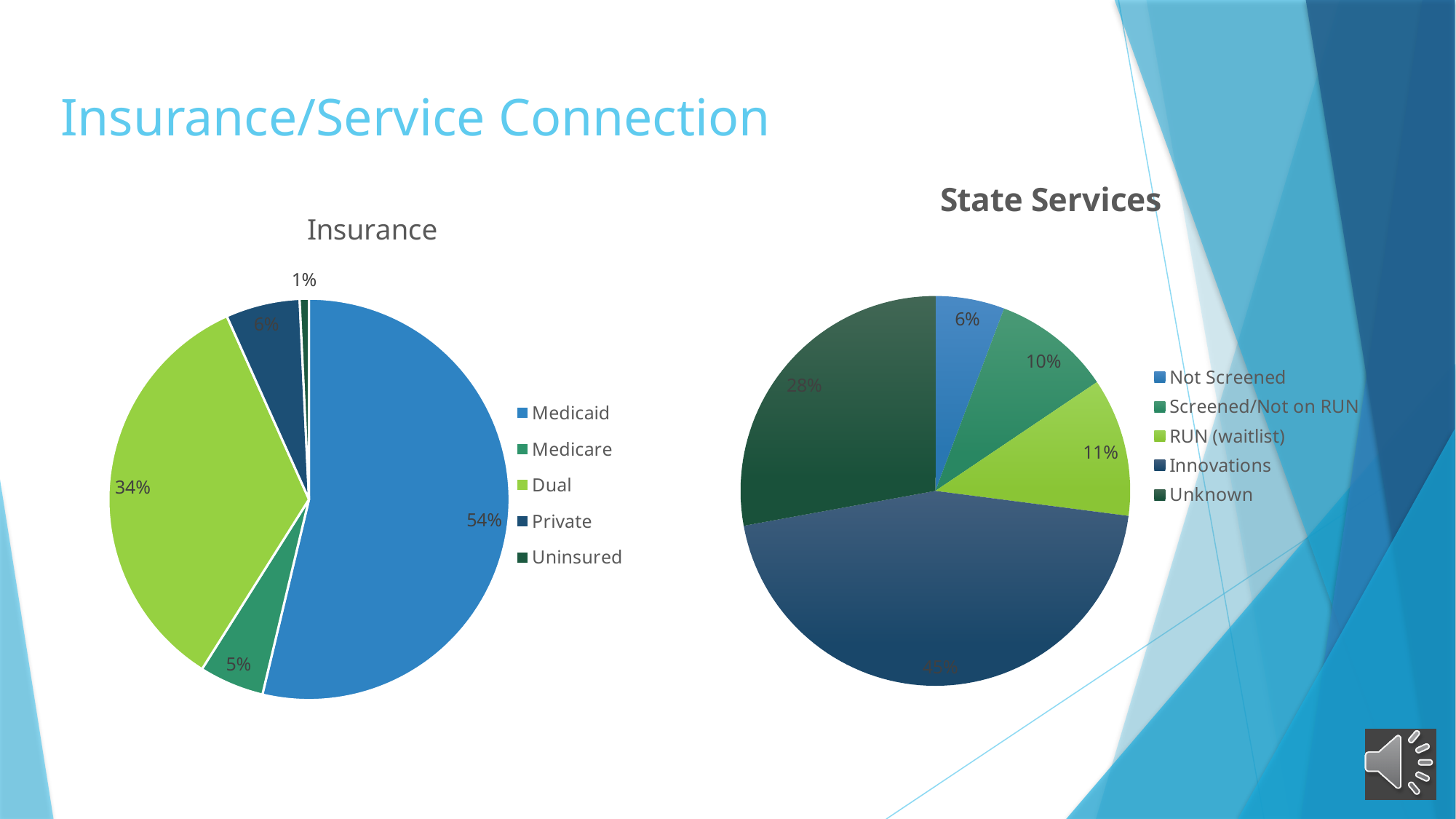
In the State Services chart, what percentage is RUN (waitlist)? 11% In the Insurance chart, which category has the largest share? Medicaid In the Insurance chart, what is the difference between the Medicaid and Dual shares? 20% In the State Services chart, which category has the smallest share? Not Screened How many categories does the Insurance chart's legend list? 5 In the Insurance chart, which is larger, Private or Medicare? Private What type of chart is the State Services chart? Pie chart In the State Services chart, what percentage is Unknown? 28% In the Insurance chart, what percentage is Dual? 34% In the Insurance chart, which category has the smallest share? Uninsured In the State Services chart, which category has the largest share? Innovations In the Insurance chart, what percentage is Medicaid? 54%